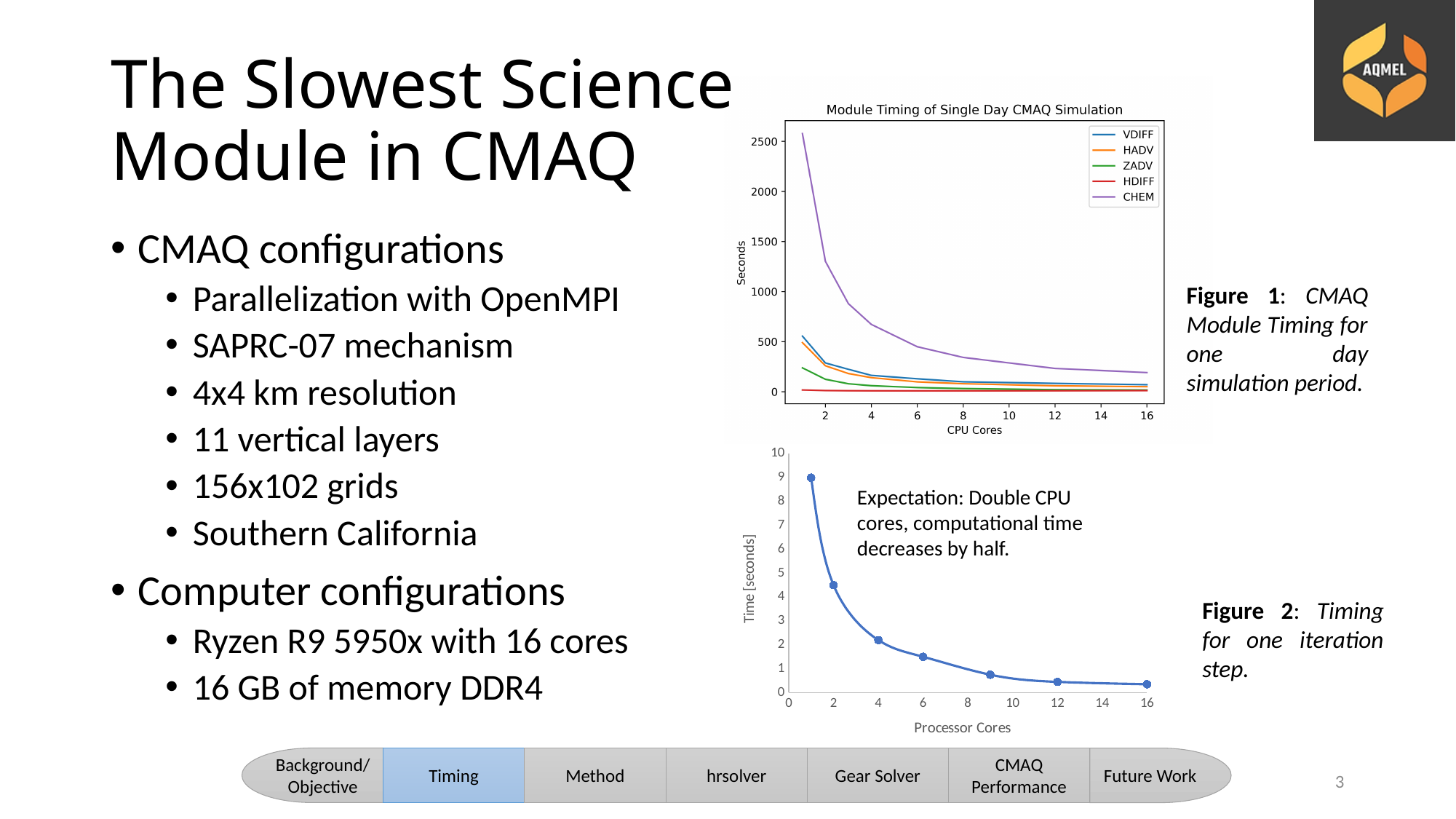
In the bottom chart (Figure 2), is the time at 16 processor cores greater or less than 1 second? less In the top chart "Module Timing of Single Day CMAQ Simulation", which is larger at 1 CPU core: VDIFF or ZADV? VDIFF In the top chart "Module Timing of Single Day CMAQ Simulation", is the CHEM value at 16 CPU cores greater or less than 500 seconds? less What is the label of the y axis of the top chart "Module Timing of Single Day CMAQ Simulation"? Seconds In the top chart "Module Timing of Single Day CMAQ Simulation", which module has the highest timing at 2 CPU cores? CHEM How many data points are plotted in the bottom chart (Figure 2, Time [seconds] vs Processor Cores)? 7 What type of chart is the top chart titled "Module Timing of Single Day CMAQ Simulation"? line chart In the bottom chart (Figure 2), is the time at 1 processor core greater or less than 8 seconds? greater How many series does the legend of the top chart "Module Timing of Single Day CMAQ Simulation" list? 5 In the top chart "Module Timing of Single Day CMAQ Simulation", do the timing values rise or fall as CPU cores increase? fall In the top chart "Module Timing of Single Day CMAQ Simulation", which module has the lowest timing across all CPU core counts? HDIFF